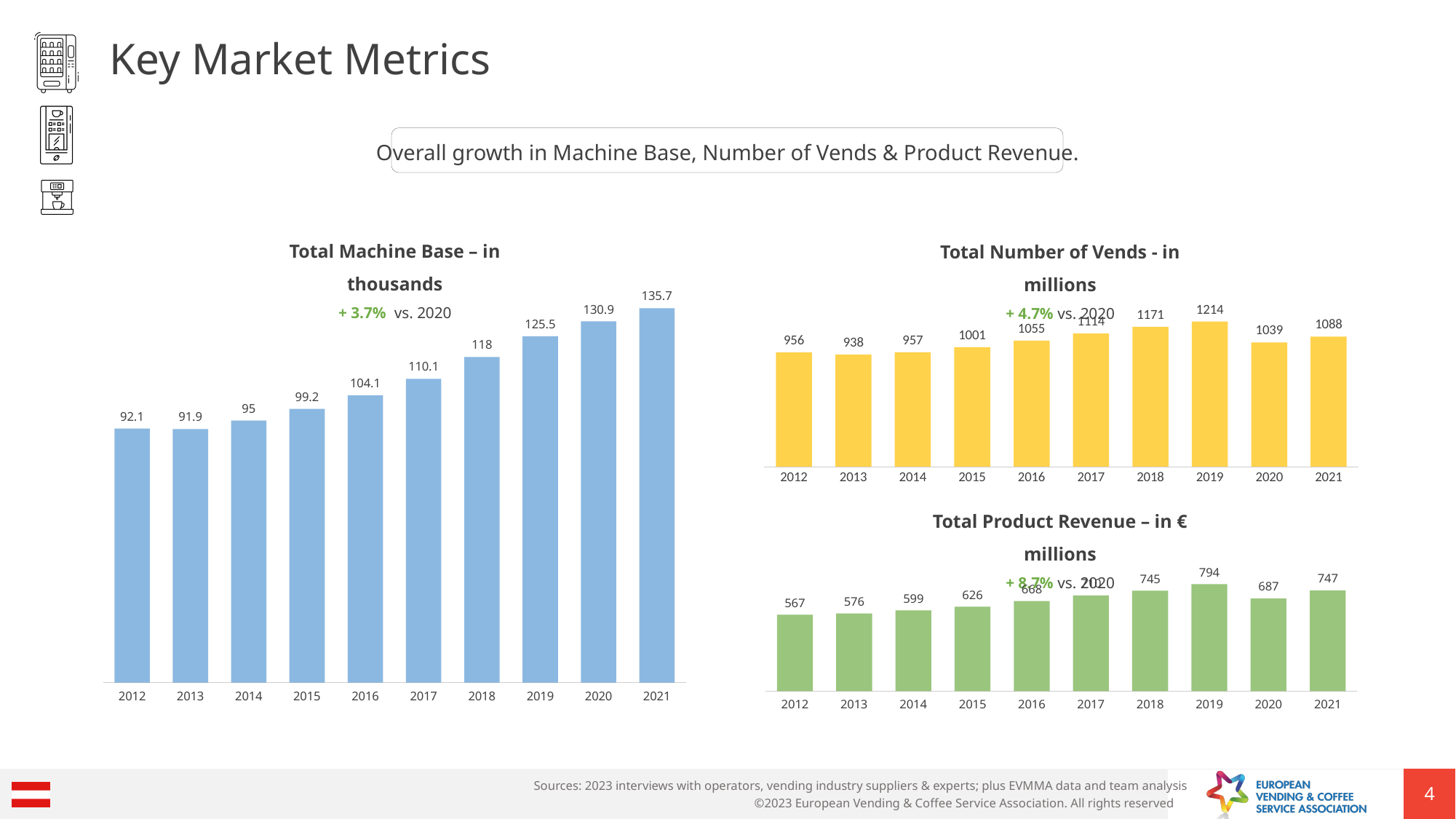
In the Total Number of Vends chart, what is the difference between the 2019 and 2020 values? 175 In the Total Machine Base chart, how many years are shown on the x axis? 10 In the Total Machine Base chart, what is the value for 2021? 135.7 In the Total Number of Vends chart, which year has the highest value? 2019 In the Total Product Revenue chart, what is the value for 2012? 567 In the Total Number of Vends chart, which is larger, the value for 2020 or the value for 2021? 2021 In the Total Machine Base chart, which year has the lowest value? 2013 What kind of chart is the Total Product Revenue chart? Bar chart In the Total Machine Base chart, what is the difference between the 2021 and 2020 values? 4.8 In the Total Product Revenue chart, which year has the highest value? 2019 What growth percentage vs. 2020 is shown on the Total Product Revenue chart? + 8.7% In the Total Number of Vends chart, what is the value for 2019? 1214